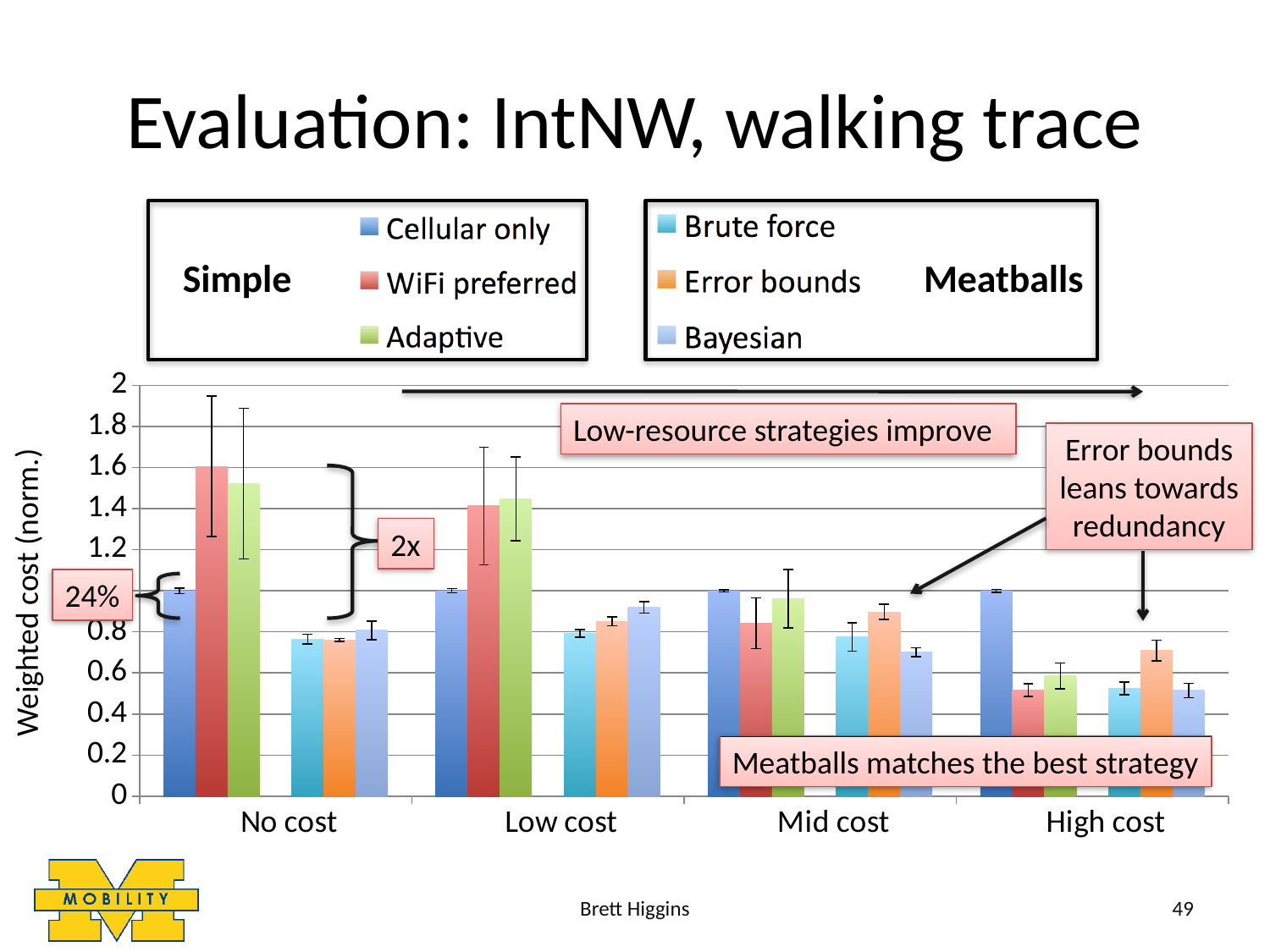
Does the value for WiFi preferred rise or fall from No cost to High cost? fall How many series do the legends list in total? 6 Which three series are grouped under the 'Meatballs' legend? Brute force, Error bounds, Bayesian How many cost categories are shown on the x axis? 4 Is the value for Error bounds at High cost greater or less than 0.6? greater Which is larger: Error bounds at High cost or Bayesian at High cost? Error bounds at High cost Which series has the highest value in the High cost category? Cellular only Is the value for Bayesian at Mid cost greater or less than 0.8? less Is the value for WiFi preferred at High cost greater or less than 0.6? less What kind of chart is shown on the slide? bar chart What is the label of the y axis? Weighted cost (norm.)